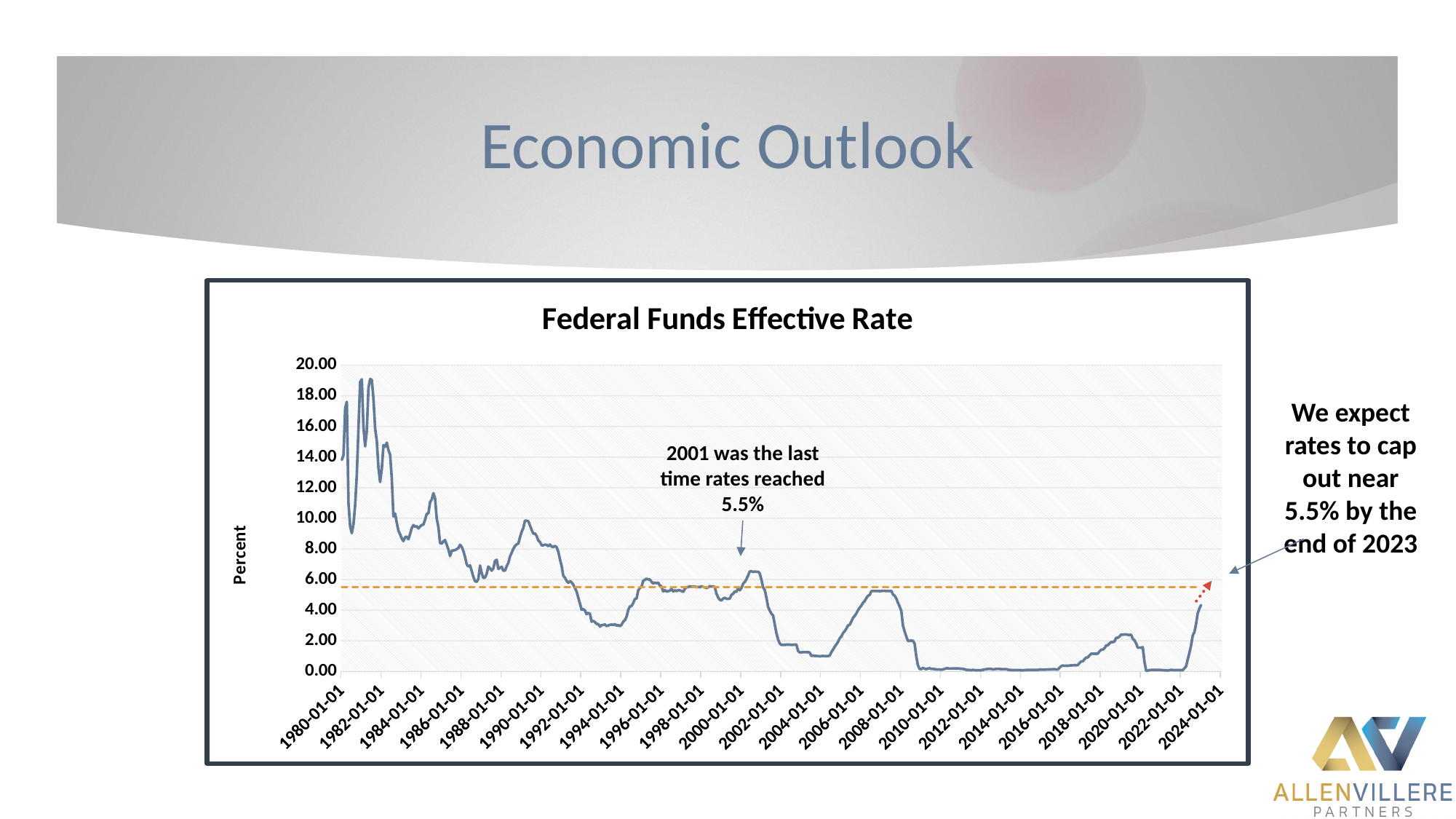
What is the title of the chart? Federal Funds Effective Rate According to the annotation on the chart, what year was the last time rates reached 5.5%? 2001 Is the peak value of the Federal Funds Effective Rate in the early 1980s greater or less than 18.00? greater Is the value of the Federal Funds Effective Rate at 2007-01-01 greater or less than 4.00? greater What kind of chart is shown on the slide? Line chart How many date labels are shown on the x axis of the chart? 23 Which is larger, the Federal Funds Effective Rate at 1982-01-01 or at 2010-01-01? 1982-01-01 Does the Federal Funds Effective Rate rise or fall between 1990-01-01 and 1993-01-01? Fall Is the value of the Federal Funds Effective Rate at 1994-01-01 greater or less than 6.00? less